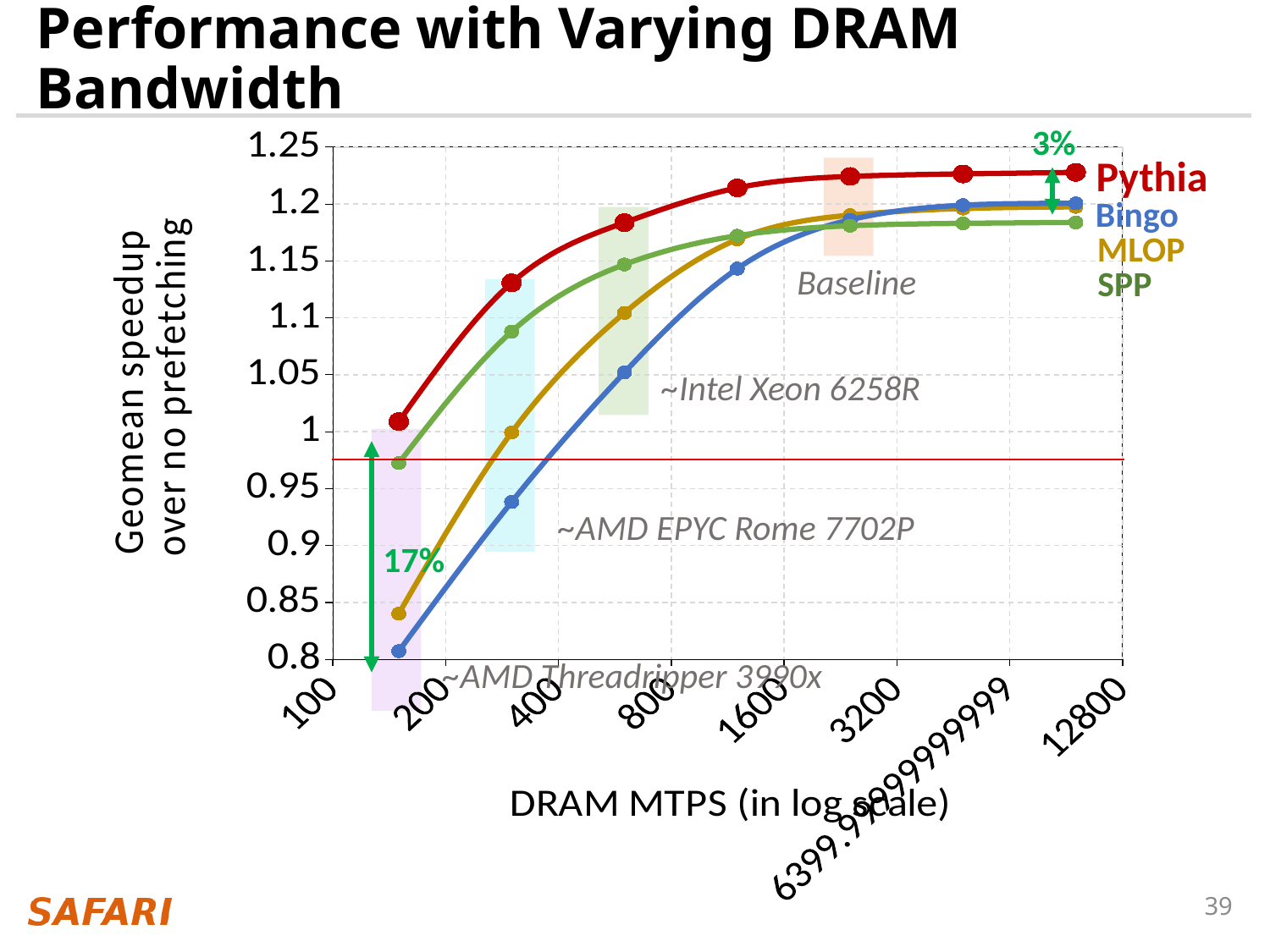
At the rightmost point, is the value for Pythia greater or less than 1.2? greater How many series does the chart's legend list? 4 Do the speedup values rise or fall as DRAM MTPS increases along the x axis? rise At the leftmost point, is the value for SPP greater or less than 1? less Which series has the lowest geomean speedup at the leftmost (lowest bandwidth) point? Bingo What is the title of the x axis? DRAM MTPS (in log scale) What percentage gap is annotated between Pythia and the lowest series at the lowest DRAM bandwidth? 17% How many data points are plotted for the Pythia series? 7 What kind of chart is shown on the slide? line chart At the leftmost point, which series has the larger value, Pythia or SPP? Pythia At the leftmost point, is the value for Bingo greater or less than 0.85? less Which series has the highest geomean speedup at the rightmost (highest bandwidth) point? Pythia